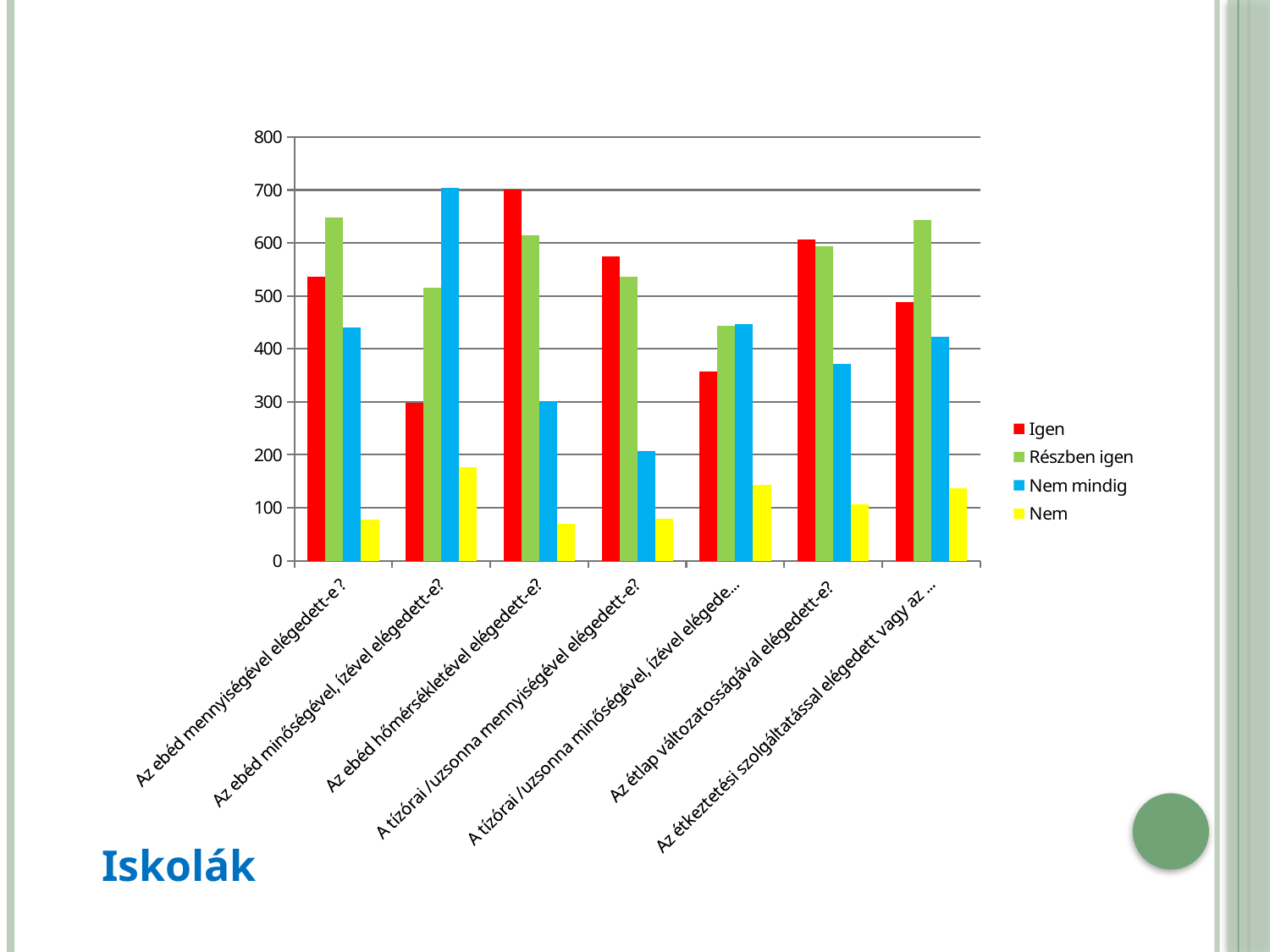
How many series does the legend list? 4 Which category has the highest "Igen" value? Az ebéd hőmérsékletével elégedett-e? Is the "Nem" value for "Az ebéd minőségével, ízével elégedett-e?" greater or less than 200? less How many categories are shown along the x axis? 7 Is the "Igen" value for "Az ebéd mennyiségével elégedett-e ?" greater or less than 500? greater For "Az ebéd minőségével, ízével elégedett-e?", which is larger: "Igen" or "Nem mindig"? Nem mindig Which series has the highest value for "Az étkeztetési szolgáltatással elégedett vagy az ..."? Részben igen Which colour represents the "Nem" series? yellow Is the "Nem mindig" value for "Az ebéd hőmérsékletével elégedett-e?" greater or less than 400? less What kind of chart is shown on the slide? bar chart What are the legend entries of the chart? Igen, Részben igen, Nem mindig, Nem For "Az étlap változatosságával elégedett-e?", which is larger: "Részben igen" or "Nem mindig"? Részben igen